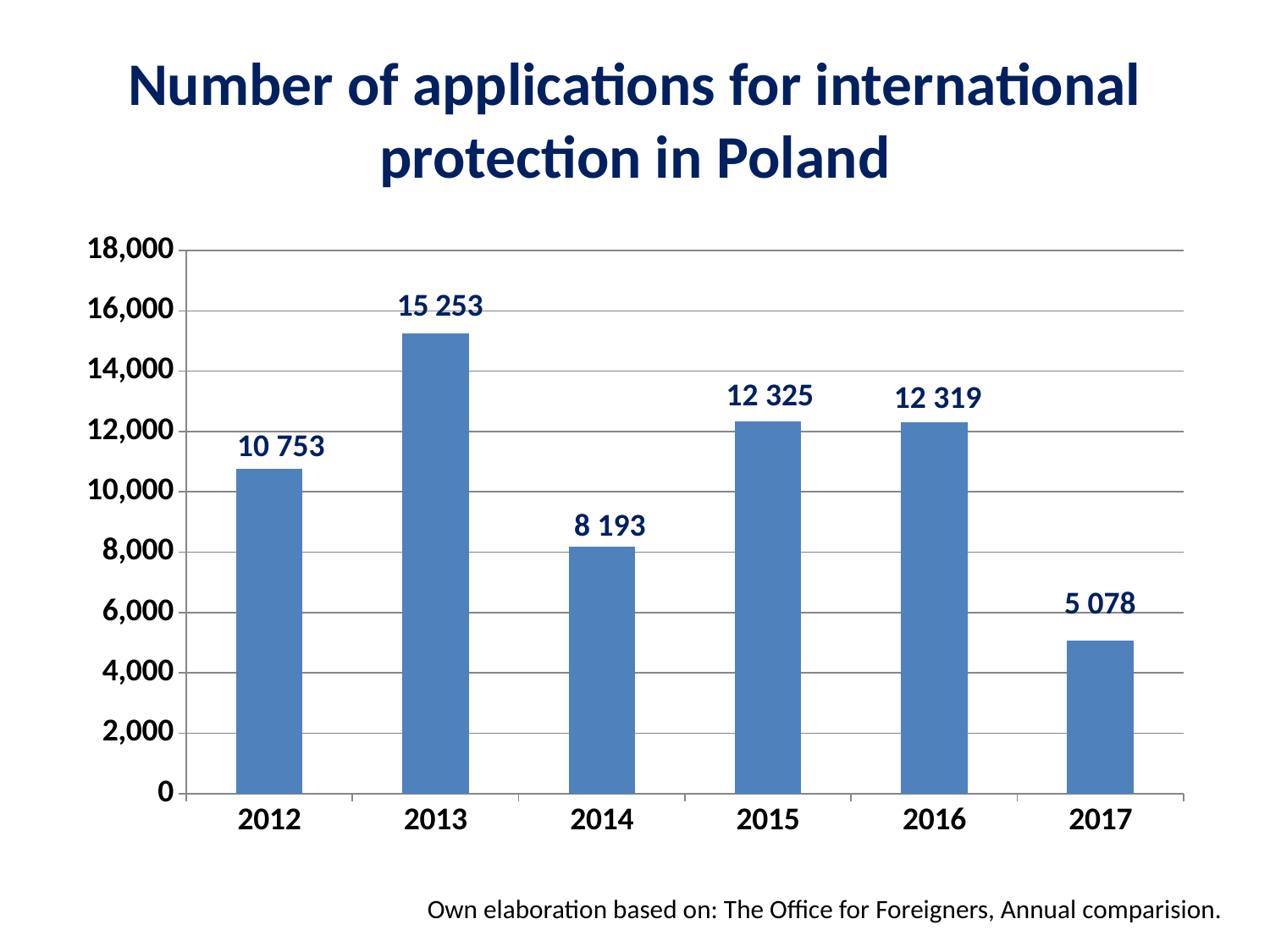
What kind of chart is shown on the slide? Bar chart Do the values rise or fall from 2016 to 2017? Fall What is the number of applications for international protection in Poland in 2017? 5 078 What is the number of applications for international protection in Poland in 2013? 15 253 How many years are shown on the chart? 6 Which year has the highest number of applications? 2013 Which year had more applications, 2012 or 2014? 2012 Is the value for 2016 greater or less than 10,000? greater Which year has the lowest number of applications? 2017 What is the difference between the number of applications in 2012 and in 2017? 5 675 What is the difference between the number of applications in 2013 and in 2014? 7 060 What is the number of applications for international protection in Poland in 2014? 8 193